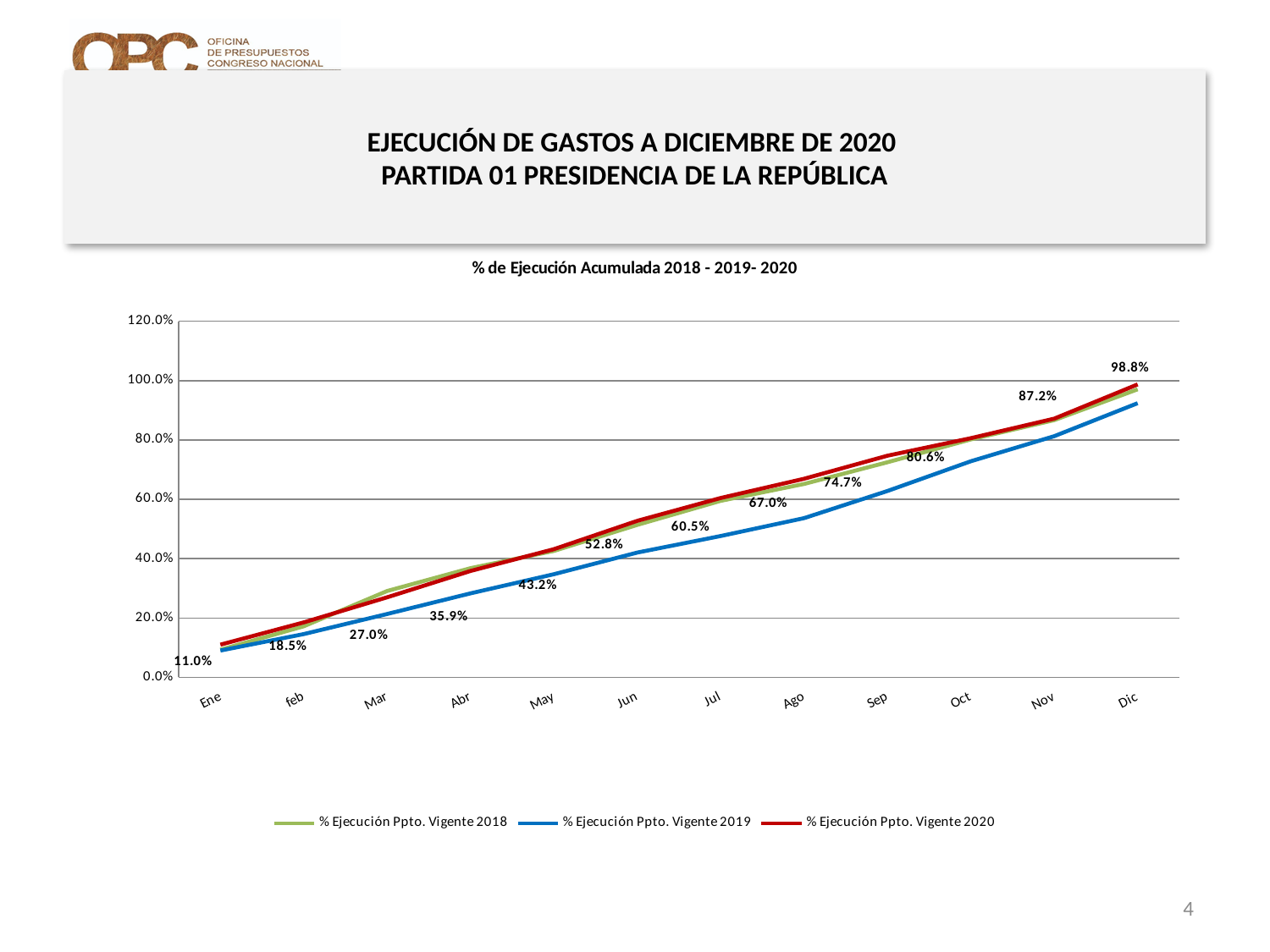
How many series does the legend list? 3 Do the values of the % Ejecución Ppto. Vigente 2020 series rise or fall from Ene to Dic? rise What is the value for % Ejecución Ppto. Vigente 2020 in Dic? 98.8% What is the title of the chart? % de Ejecución Acumulada 2018 - 2019- 2020 How many months are shown on the x axis? 12 What is the value for % Ejecución Ppto. Vigente 2020 in Sep? 74.7% In Sep, which series has the larger value: % Ejecución Ppto. Vigente 2019 or % Ejecución Ppto. Vigente 2020? % Ejecución Ppto. Vigente 2020 What type of chart is shown on the slide? line chart What is the difference between the 2020 values for Dic and Nov? 11.6% Is the value for % Ejecución Ppto. Vigente 2019 in Dic greater or less than 80.0%? greater What is the value for % Ejecución Ppto. Vigente 2020 in Jun? 52.8% What is the value for % Ejecución Ppto. Vigente 2020 in Ene? 11.0%